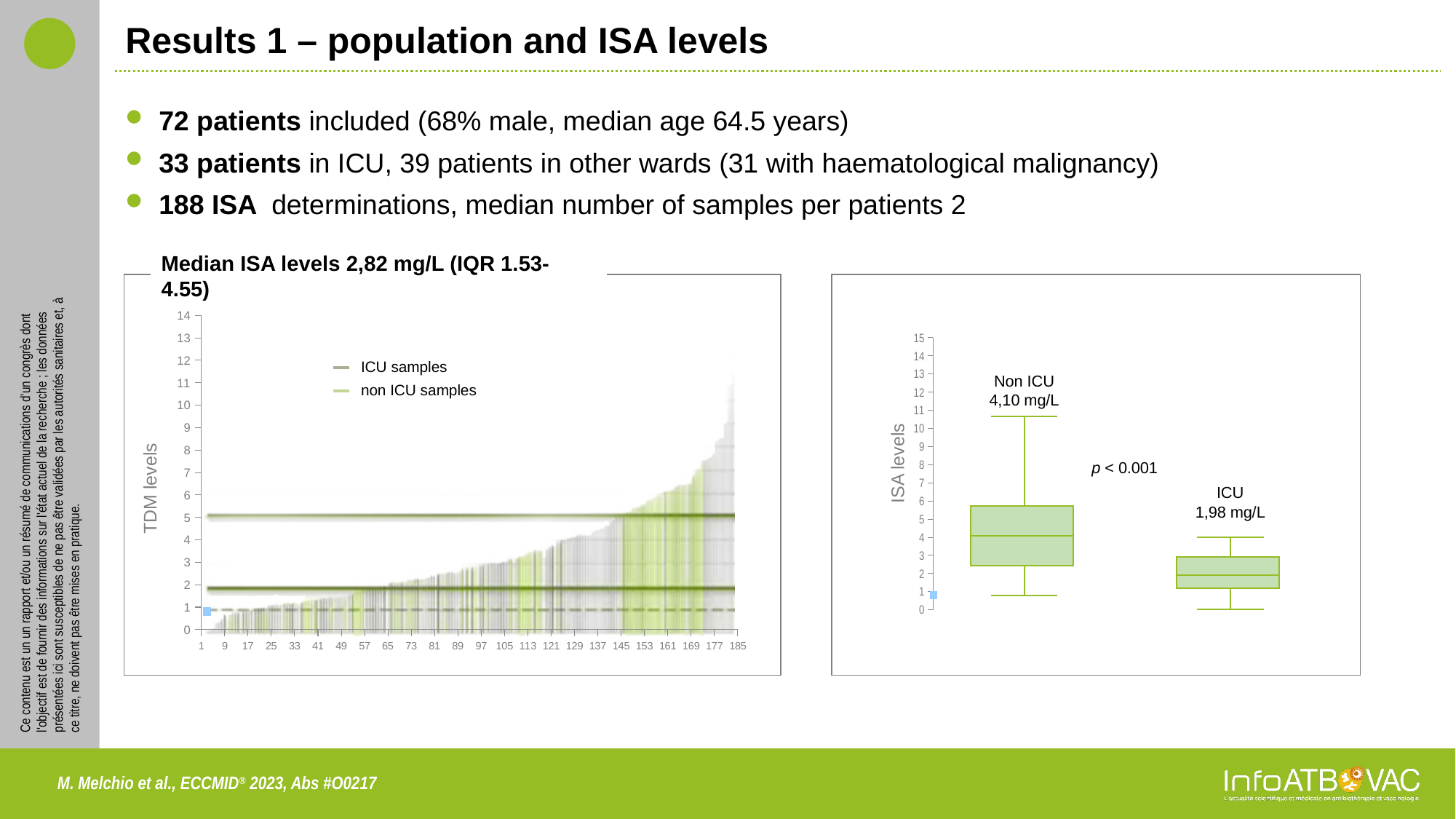
What is the y-axis label of the right chart? ISA levels How many series does the legend of the left chart list? 2 What kind of chart is the left chart? bar chart On the right chart, which group has the higher median ISA level, Non ICU or ICU? Non ICU What median ISA level is stated in the title of the left chart? 2,82 mg/L On the right chart, what is the median ISA level for the ICU group? 1,98 mg/L On the right chart, is the top of the Non ICU upper whisker greater or less than 10? greater On the right chart, what is the difference between the Non ICU and ICU median ISA levels? 2,12 mg/L On the left chart, do the TDM levels rise or fall from left to right along the x axis? rise On the right chart, what p-value is shown for the comparison between the Non ICU and ICU groups? p < 0.001 On the right chart, how many groups are plotted? 2 On the right chart, what is the median ISA level for the Non ICU group? 4,10 mg/L